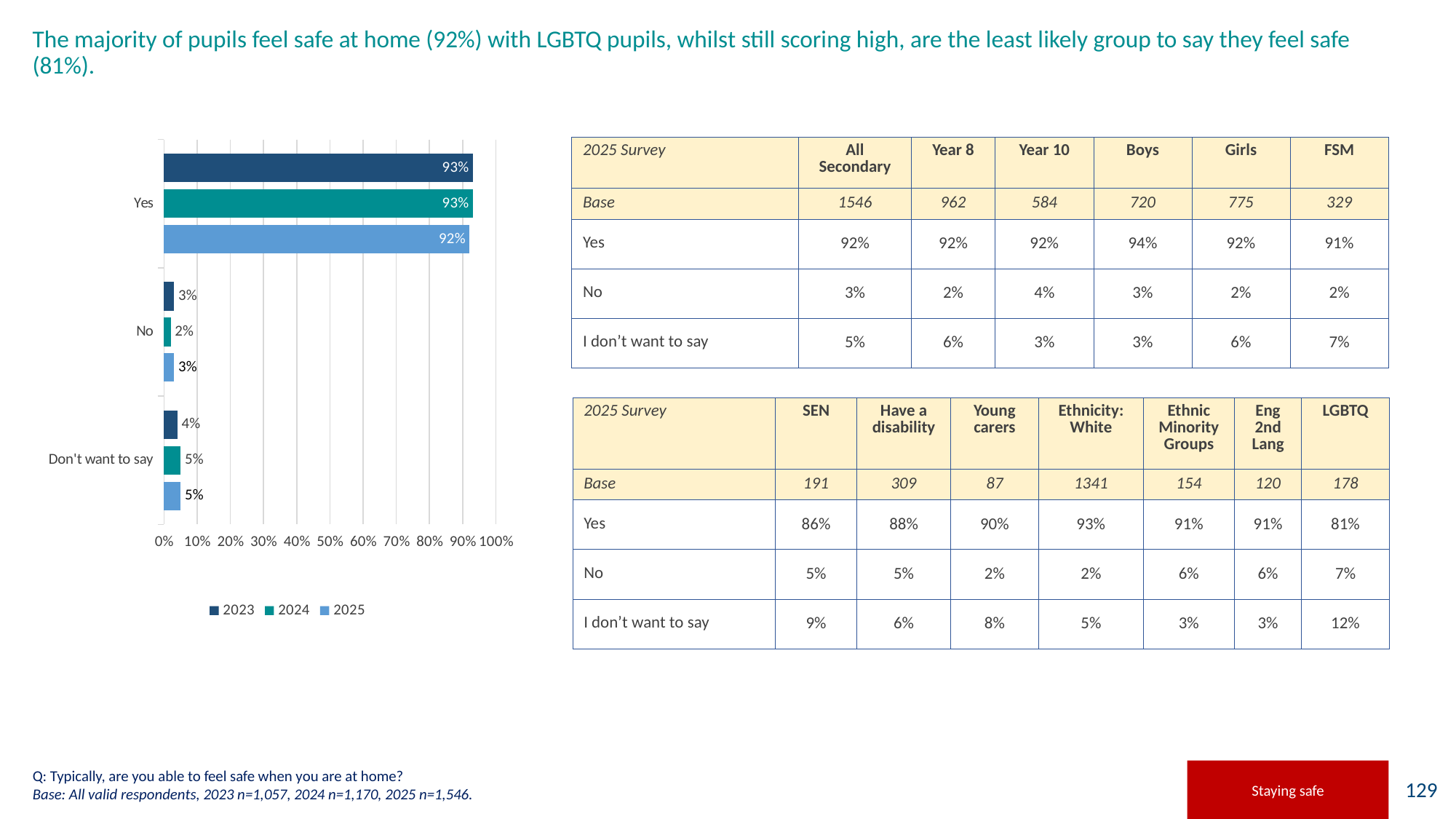
How many series does the chart legend list? 3 Which response category has the highest value for 2025 in the chart? Yes Which response category has the lowest value for 2024 in the chart? No What is the difference between the 2023 and 2025 values for 'Yes' in the chart? 1% How many response categories are shown on the chart? 3 What is the 2023 value for 'Don't want to say' in the chart? 4% What is the 2025 value for 'Yes' in the chart? 92% What kind of chart is shown on the slide? bar chart Which is larger in the chart: the 2025 value for 'Don't want to say' or the 2025 value for 'No'? Don't want to say What is the 2023 value for 'Yes' in the chart? 93% Which series in the chart legend is shown in the darkest blue? 2023 What is the 2024 value for 'No' in the chart? 2%